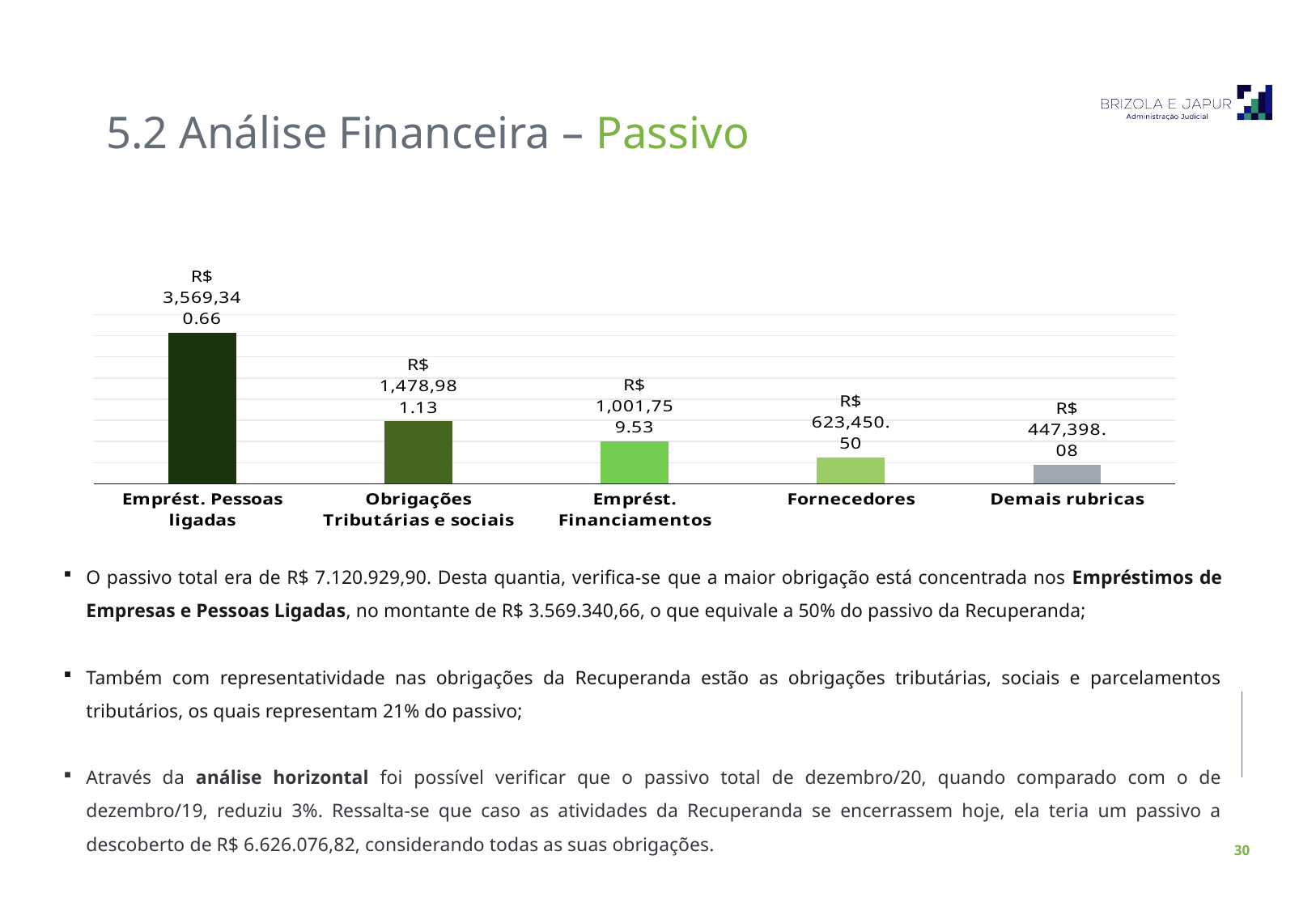
What is the value for Obrigações Tributárias e sociais? R$ 1,478,981.13 What is the value for Demais rubricas? R$ 447,398.08 What is the difference between Emprést. Pessoas ligadas and Obrigações Tributárias e sociais? R$ 2,090,359.53 Which is larger, Fornecedores or Demais rubricas? Fornecedores Which category has the lowest value? Demais rubricas What type of chart is shown on the slide? Bar chart How many categories are shown in the chart? 5 What is the value for Emprést. Financiamentos? R$ 1,001,759.53 What is the value for Emprést. Pessoas ligadas? R$ 3,569,340.66 Do the values rise or fall from left to right across the categories? Fall What is the value for Fornecedores? R$ 623,450.50 Which category has the highest value? Emprést. Pessoas ligadas